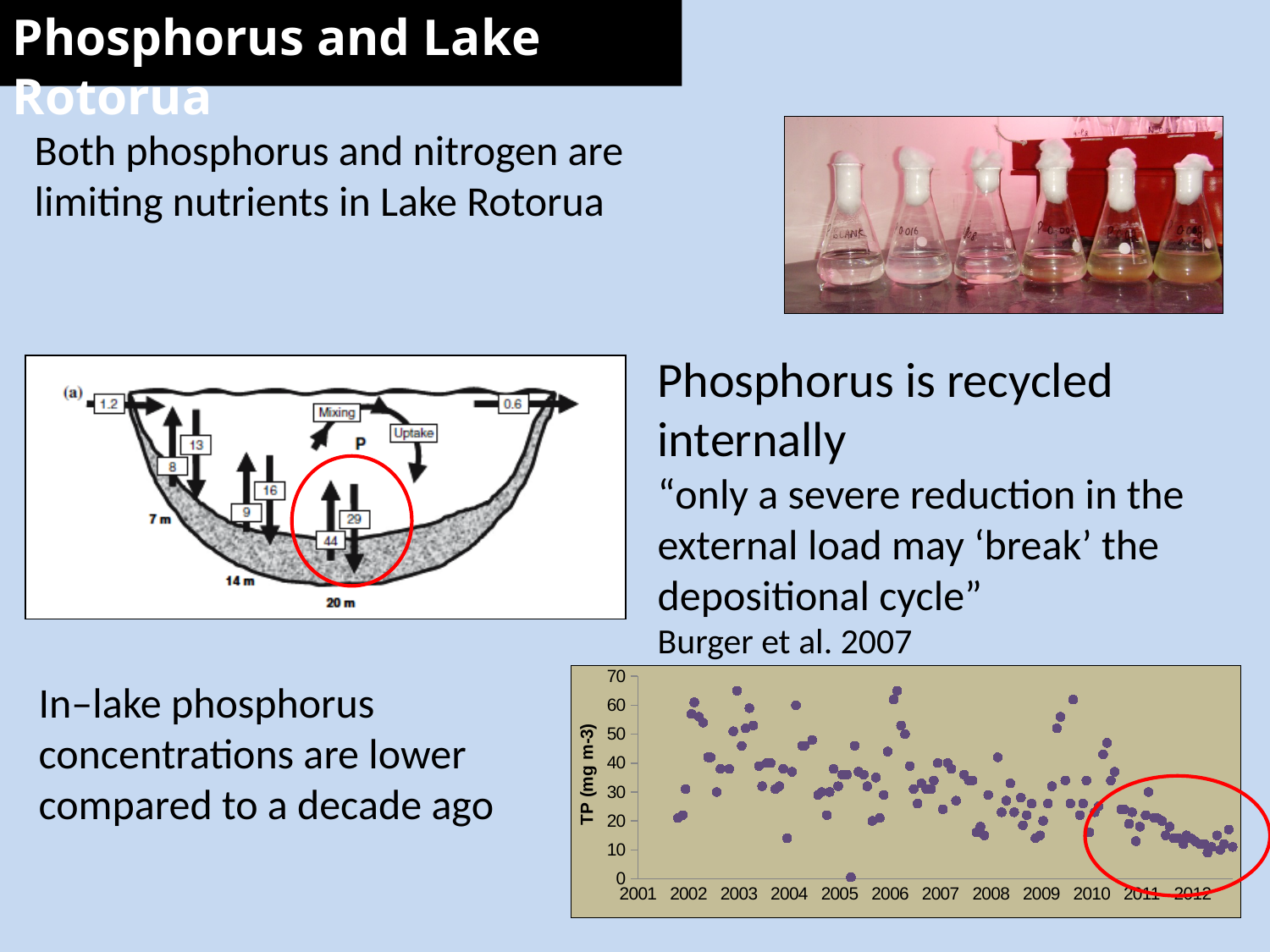
What is the highest tick value shown on the y axis of the scatter chart? 70 What is the first year labelled on the x axis of the scatter chart? 2001 In the scatter chart at the bottom right, do the TP values generally rise or fall from 2001 to 2012? fall How many year labels are shown on the x axis of the scatter chart? 12 What is the last year labelled on the x axis of the scatter chart? 2012 In the scatter chart, are the points plotted during 2012 greater or less than 30 mg m-3? less What kind of chart is shown at the bottom right of the slide? scatter chart In the scatter chart, near which year does the lowest plotted point (at 0) occur? 2005 What is the label on the y axis of the scatter chart at the bottom right? TP (mg m-3) In the scatter chart, are the TP values in 2002 generally larger or smaller than those in 2012? larger In the scatter chart, is the lowest point plotted in 2012 greater or less than 20? less